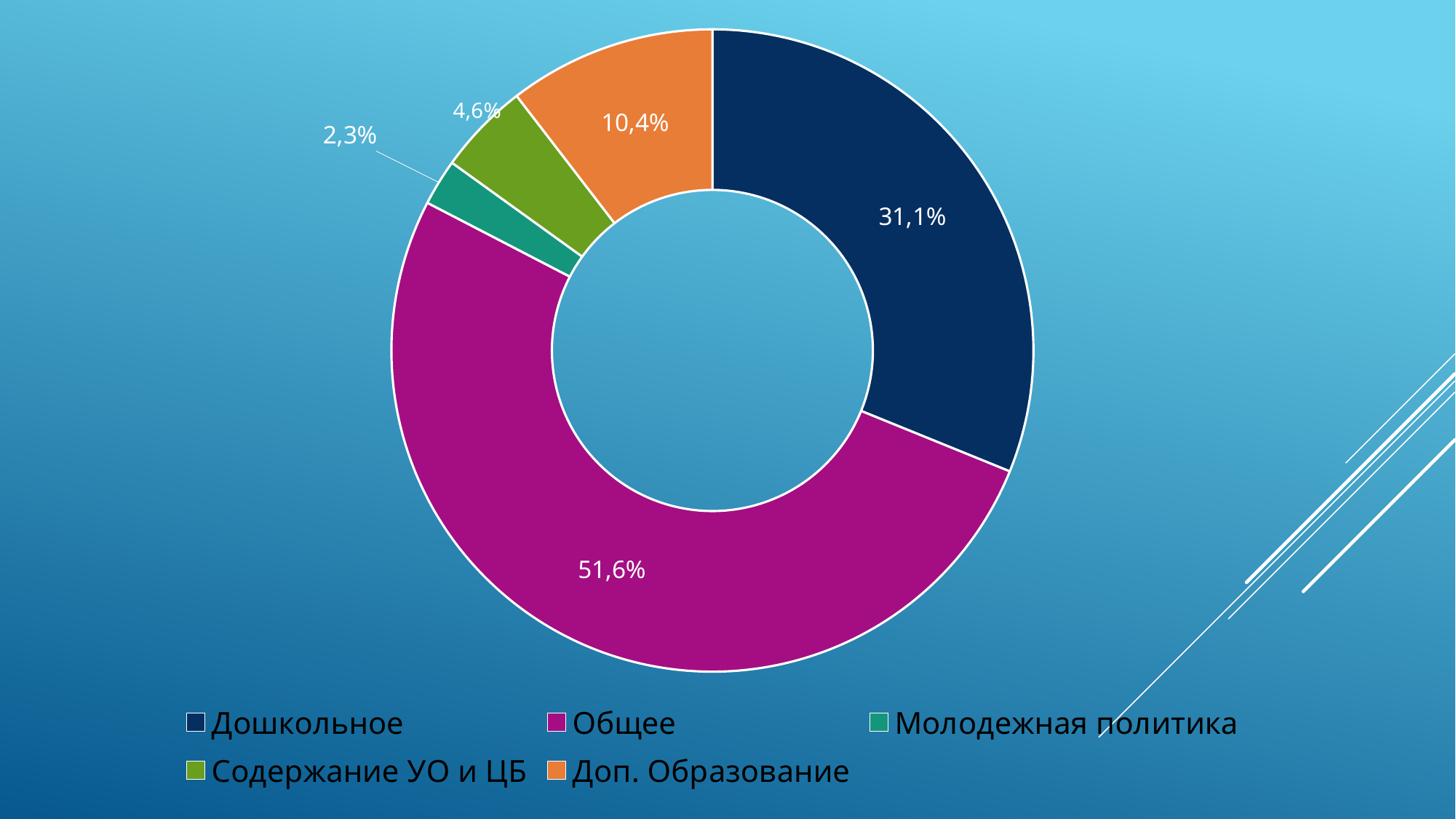
What is the difference between the shares of Общее and Дошкольное? 20,5% What share of the chart does Общее account for? 51,6% What colour is the slice for Доп. Образование? Orange What kind of chart is shown on the slide? Doughnut (pie) chart How many categories does the chart show? 5 Which category has the largest share? Общее What is the value shown for Молодежная политика? 2,3% Which category has the smallest share? Молодежная политика What is the value shown for Дошкольное? 31,1% What is the value shown for Доп. Образование? 10,4% What is the value shown for Содержание УО и ЦБ? 4,6% Which is larger, Доп. Образование or Содержание УО и ЦБ? Доп. Образование